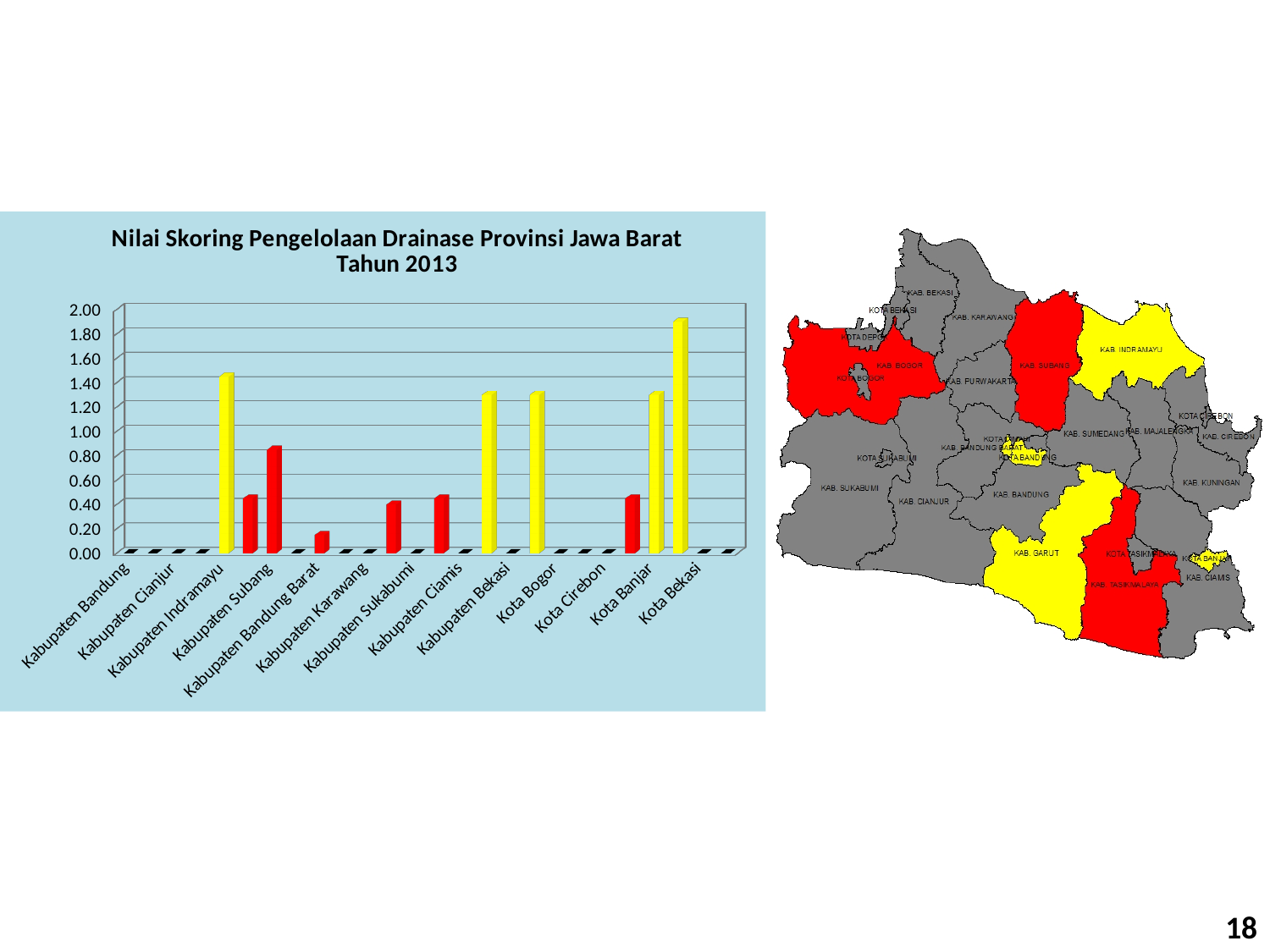
What two colours are used for the bars in the chart? yellow and red Is the value for Kabupaten Indramayu greater or less than 1.20? greater Is the value for Kabupaten Bandung Barat greater or less than 0.40? less Which has the larger value, Kabupaten Indramayu or Kabupaten Bandung Barat? Kabupaten Indramayu What kind of chart is shown on the slide? bar chart How many categories are listed along the x axis of the chart? 13 Is the value for Kota Banjar greater or less than 1.00? greater What is the title of the chart on the slide? Nilai Skoring Pengelolaan Drainase Provinsi Jawa Barat Tahun 2013